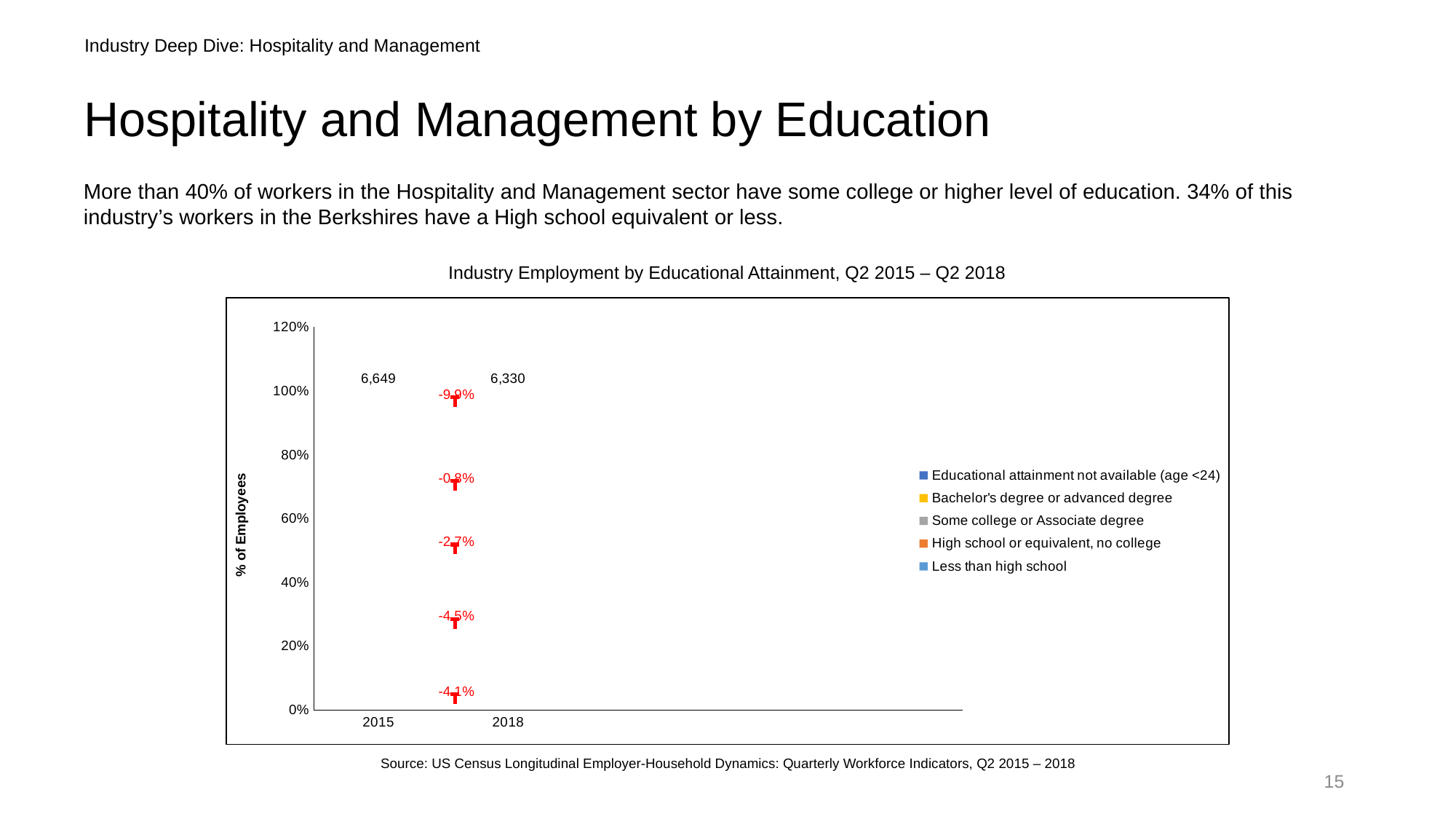
Does the employment total rise or fall from 2015 to 2018? fall What is the title of the chart? Industry Employment by Educational Attainment, Q2 2015 – Q2 2018 What is the maximum value shown on the y axis? 120% What is the label on the y axis? % of Employees Which year has the larger employment total label, 2015 or 2018? 2015 How many years (categories) are shown on the x axis? 2 How many series does the legend list? 5 What is the employment total printed above the 2018 bar? 6,330 What is the difference between the 2015 total (6,649) and the 2018 total (6,330)? 319 What is the employment total printed above the 2015 bar? 6,649 What is the largest percentage change label shown in red on the chart? -9.9% What is the smallest percentage change label shown in red on the chart? -0.8%